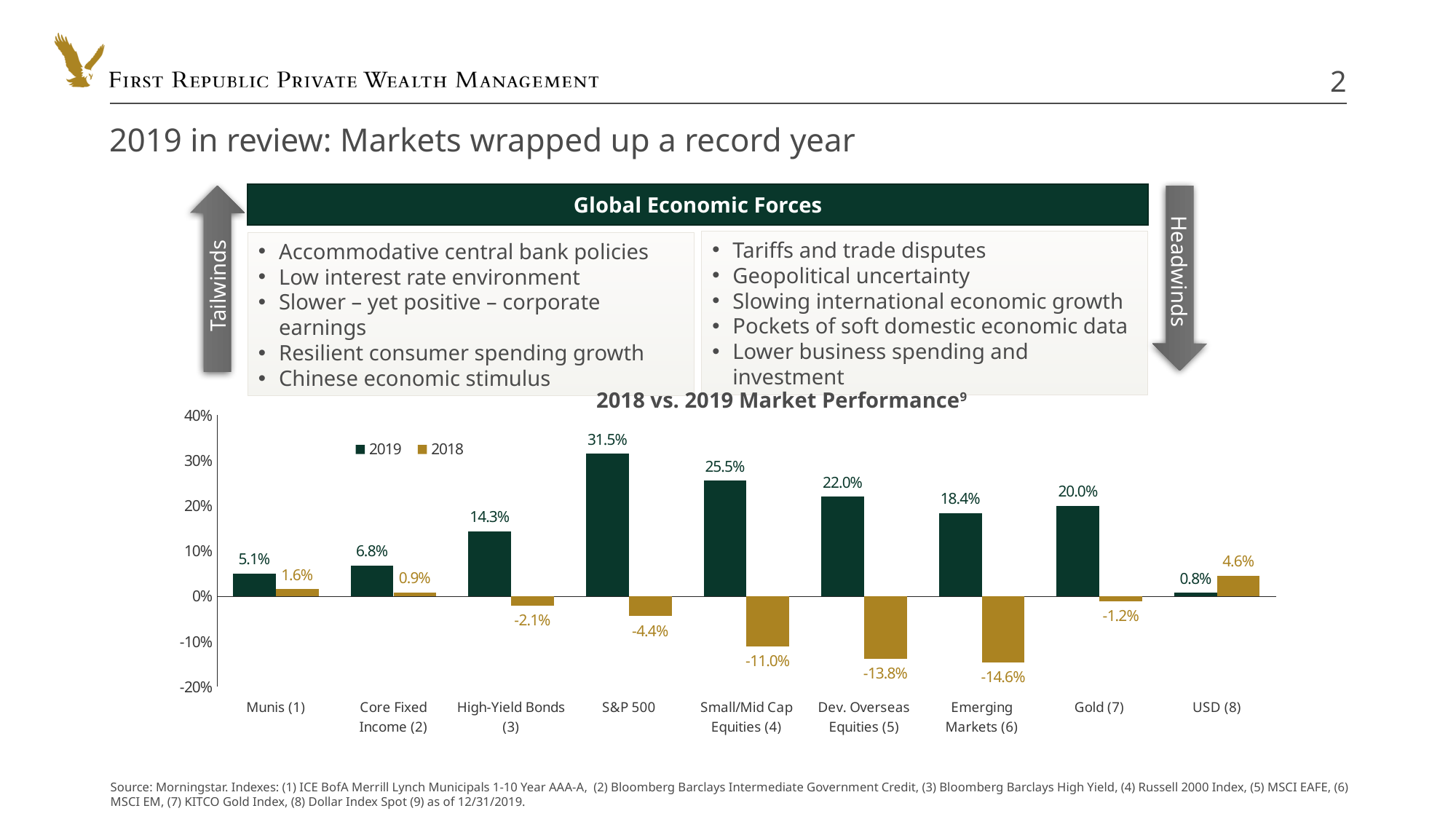
What was the 2019 value for the S&P 500? 31.5% How many series does the legend list? 2 Which is larger for USD (8): the 2019 value or the 2018 value? 2018 What was the 2019 value for Gold (7)? 20.0% What kind of chart is shown? bar chart What is the title of the chart? 2018 vs. 2019 Market Performance How many categories are shown on the x axis? 9 What is the difference between the 2019 and 2018 values for Small/Mid Cap Equities (4)? 36.5% What was the 2018 value for Emerging Markets (6)? -14.6% Which category had the highest 2019 value? S&P 500 Which category had the lowest 2018 value? Emerging Markets (6) Which category had the lowest 2019 value? USD (8)